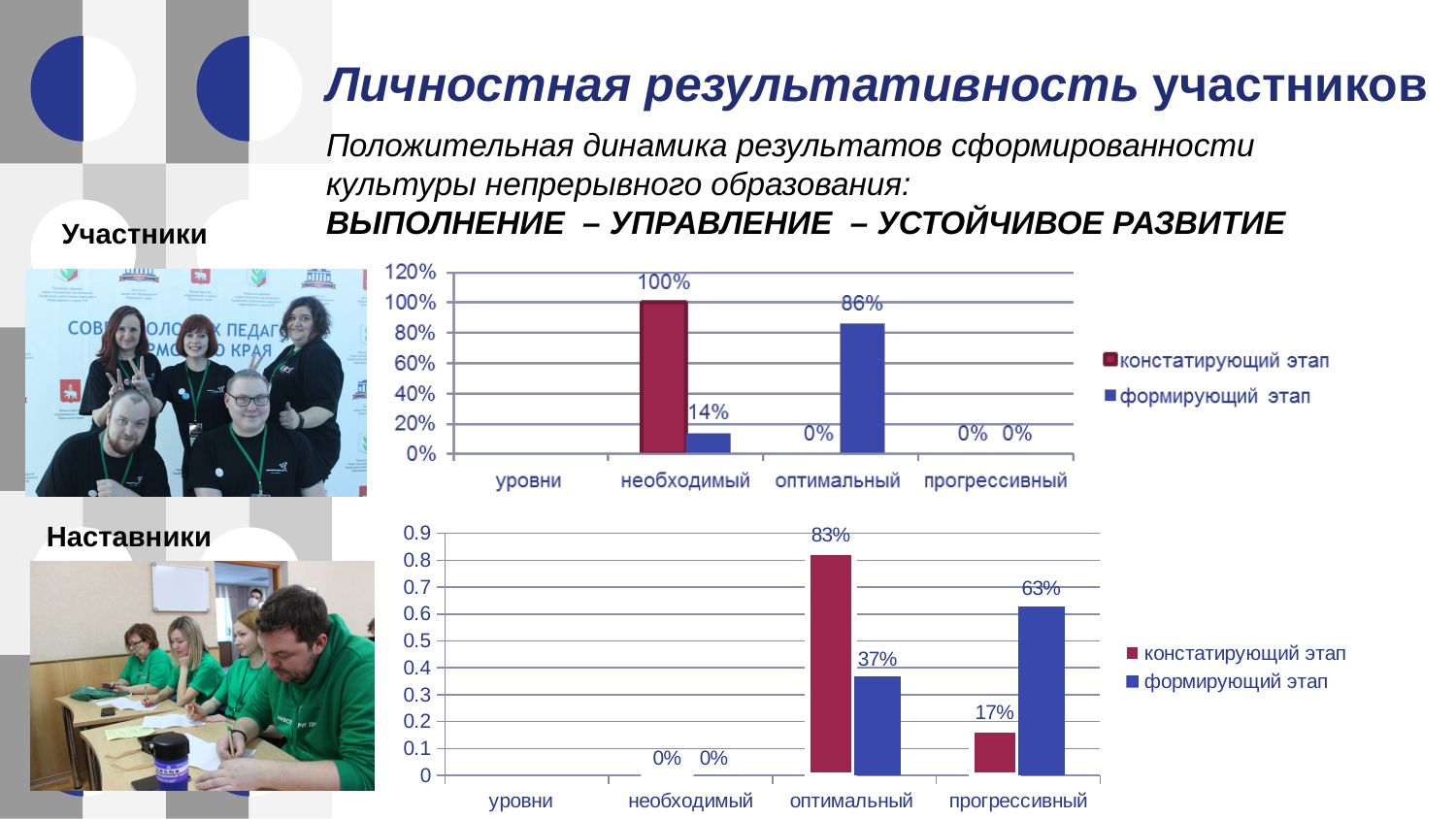
How many series does the legend of the top chart list? 2 In the top chart, what is the value for оптимальный in the формирующий этап series? 86% In the bottom chart, what is the value for прогрессивный in the формирующий этап series? 63% In the bottom chart, what is the difference between the формирующий этап and констатирующий этап values for прогрессивный? 46% In the bottom chart, what is the value for оптимальный in the констатирующий этап series? 83% In the bottom chart, which is larger for оптимальный: the констатирующий этап value or the формирующий этап value? констатирующий этап In the top chart, what is the value for необходимый in the констатирующий этап series? 100% In the bottom chart, what is the value for прогрессивный in the констатирующий этап series? 17% In the top chart, which category has the highest value in the формирующий этап series? оптимальный In the top chart, what is the difference between the констатирующий этап and формирующий этап values for необходимый? 86% In the top chart, what is the value for необходимый in the формирующий этап series? 14% What type of chart is the bottom chart? bar chart